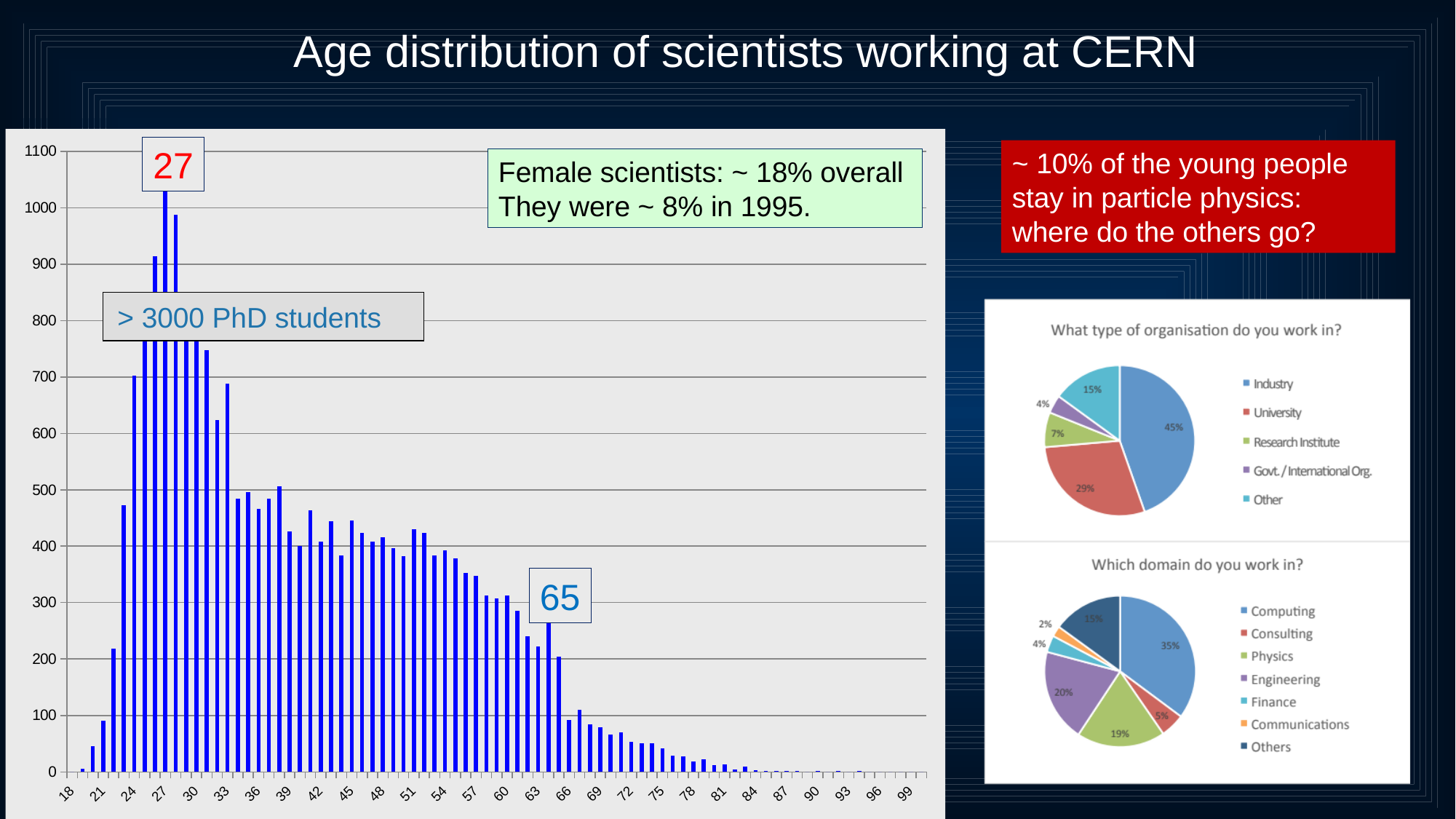
In the age distribution bar chart, which age has the highest number of scientists? 27 In the age distribution bar chart, is the value for age 27 greater or less than 1000? greater In the age distribution bar chart, do the values rise or fall along the x axis from age 27 to age 99? fall In the pie chart 'What type of organisation do you work in?', what share is Industry? 45% What kind of chart is the large age distribution chart on the left of the slide? bar chart In the age distribution bar chart, is the value for age 18 greater or less than 100? less In the pie chart 'What type of organisation do you work in?', which category has the smallest share? Govt. / International Org. In the pie chart 'Which domain do you work in?', which domain has the largest share? Computing In the pie chart 'What type of organisation do you work in?', what is the difference between the Industry and University shares? 16% In the pie chart 'Which domain do you work in?', what share is Physics? 19% In the pie chart 'What type of organisation do you work in?', how many categories does the legend list? 5 In the pie chart 'Which domain do you work in?', how many domains does the legend list? 7